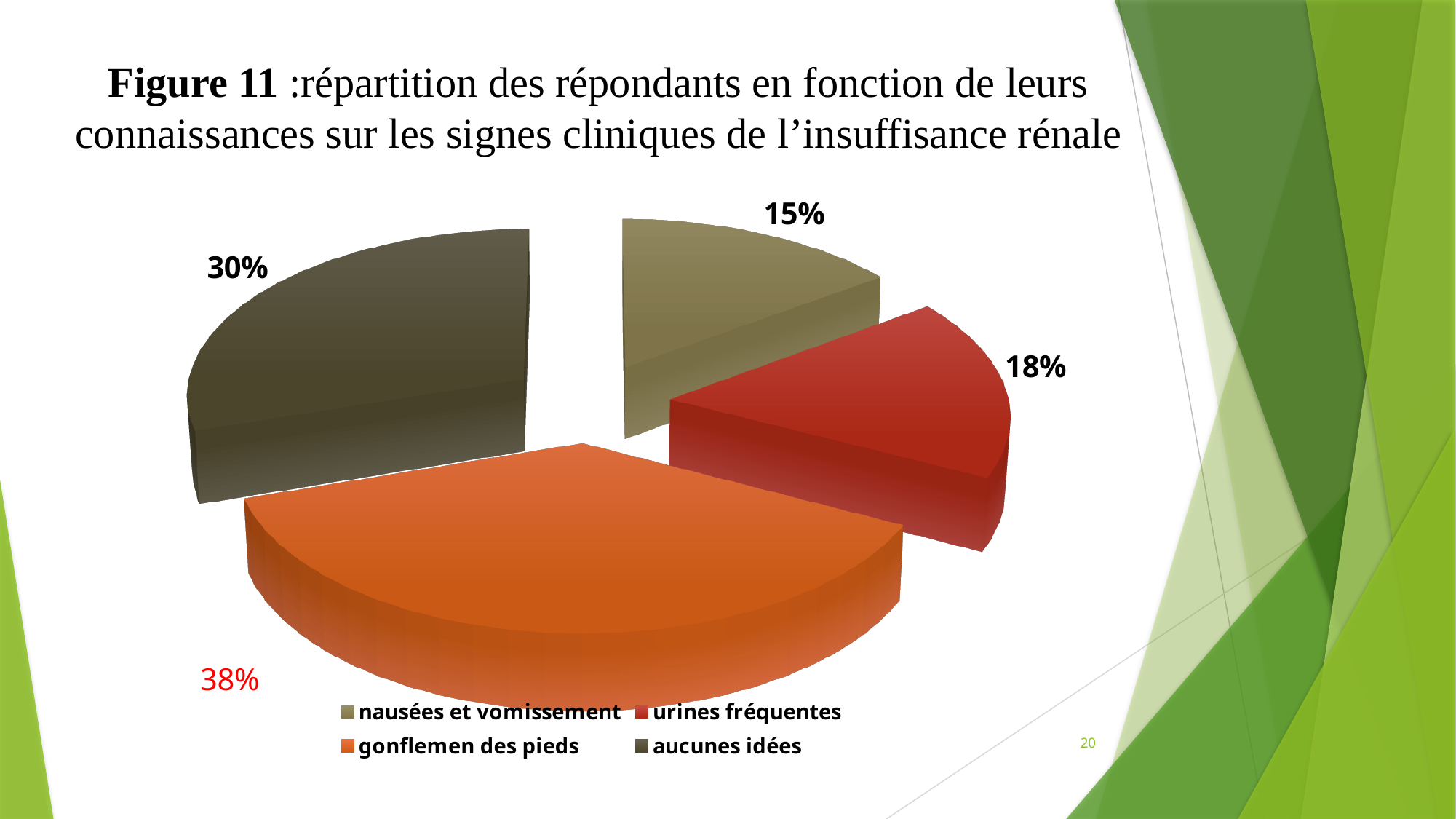
What percentage of respondents is shown for "urines fréquentes"? 18% Which category has the smallest share of the pie? nausées et vomissement Which is larger, the share for "urines fréquentes" or the share for "nausées et vomissement"? urines fréquentes What colour is the slice for "urines fréquentes"? red What is the figure number given in the chart title? Figure 11 Which category has the largest share of the pie? gonflemen des pieds What kind of chart is shown on the slide? pie chart What percentage of respondents is shown for "gonflemen des pieds"? 38% What is the difference in percentage points between "gonflemen des pieds" and "aucunes idées"? 8 What percentage of respondents is shown for "nausées et vomissement"? 15% What percentage of respondents is shown for "aucunes idées"? 30% How many categories does the pie chart show? 4